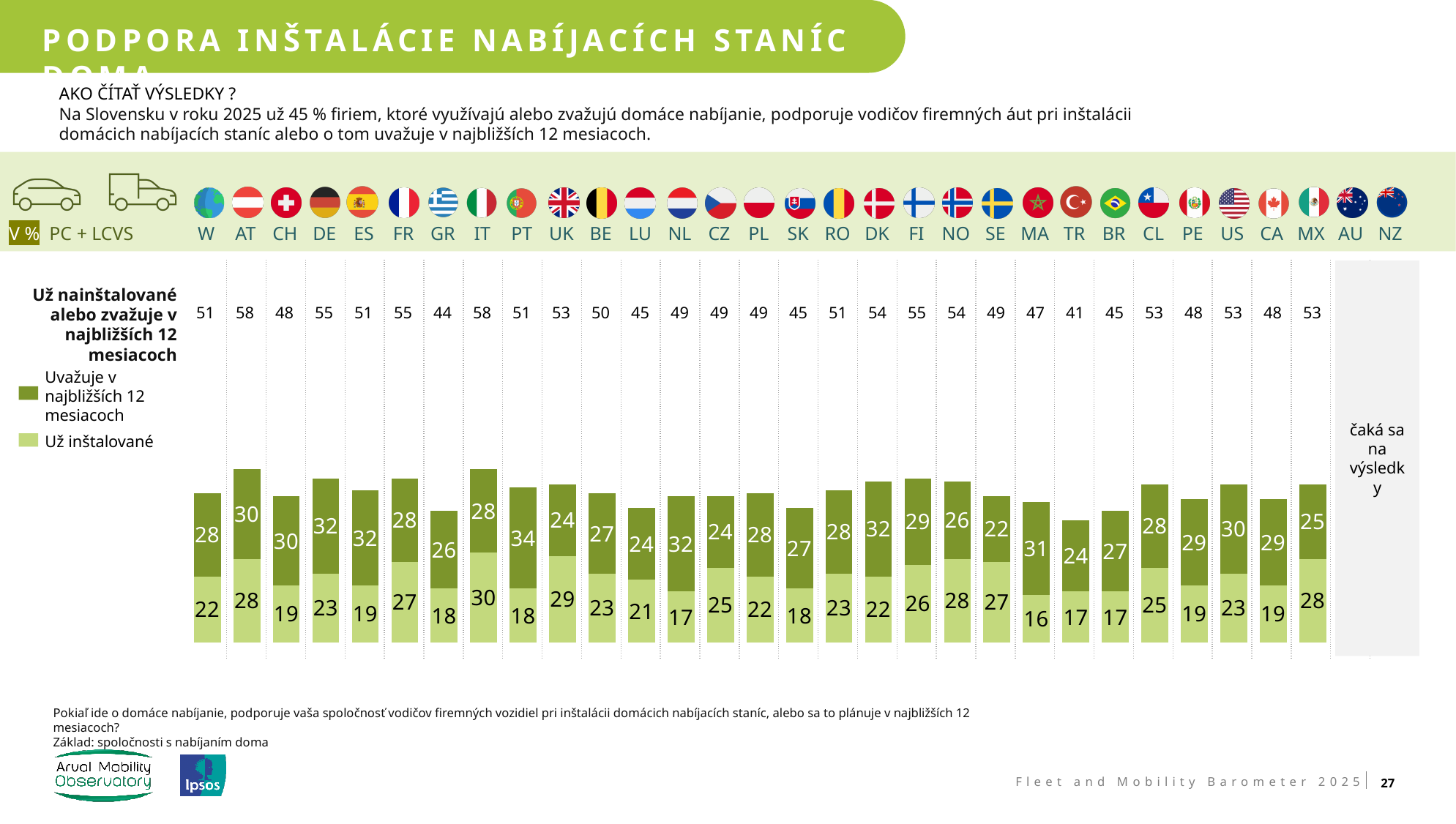
Which country has the highest 'Už inštalované' value? IT Which two countries are marked as 'čaká sa na výsledky' (awaiting results)? AU and NZ Which country has the lowest total 'Už nainštalované alebo zvažuje v najbližších 12 mesiacoch' value? TR What is the difference between the 'Už inštalované' values for IT and GR? 12 How many series does the legend list? 2 Which is larger, the 'Už inštalované' value for UK or for NL? UK Which country has the highest 'Uvažuje v najbližších 12 mesiacoch' value? PT What kind of chart is shown on the slide? Stacked bar chart What is the 'Už inštalované' value for SK? 18 What is the total 'Už nainštalované alebo zvažuje v najbližších 12 mesiacoch' value shown for TR? 41 What is the 'Uvažuje v najbližších 12 mesiacoch' value for PT? 34 Which country has the lowest 'Už inštalované' value? MA